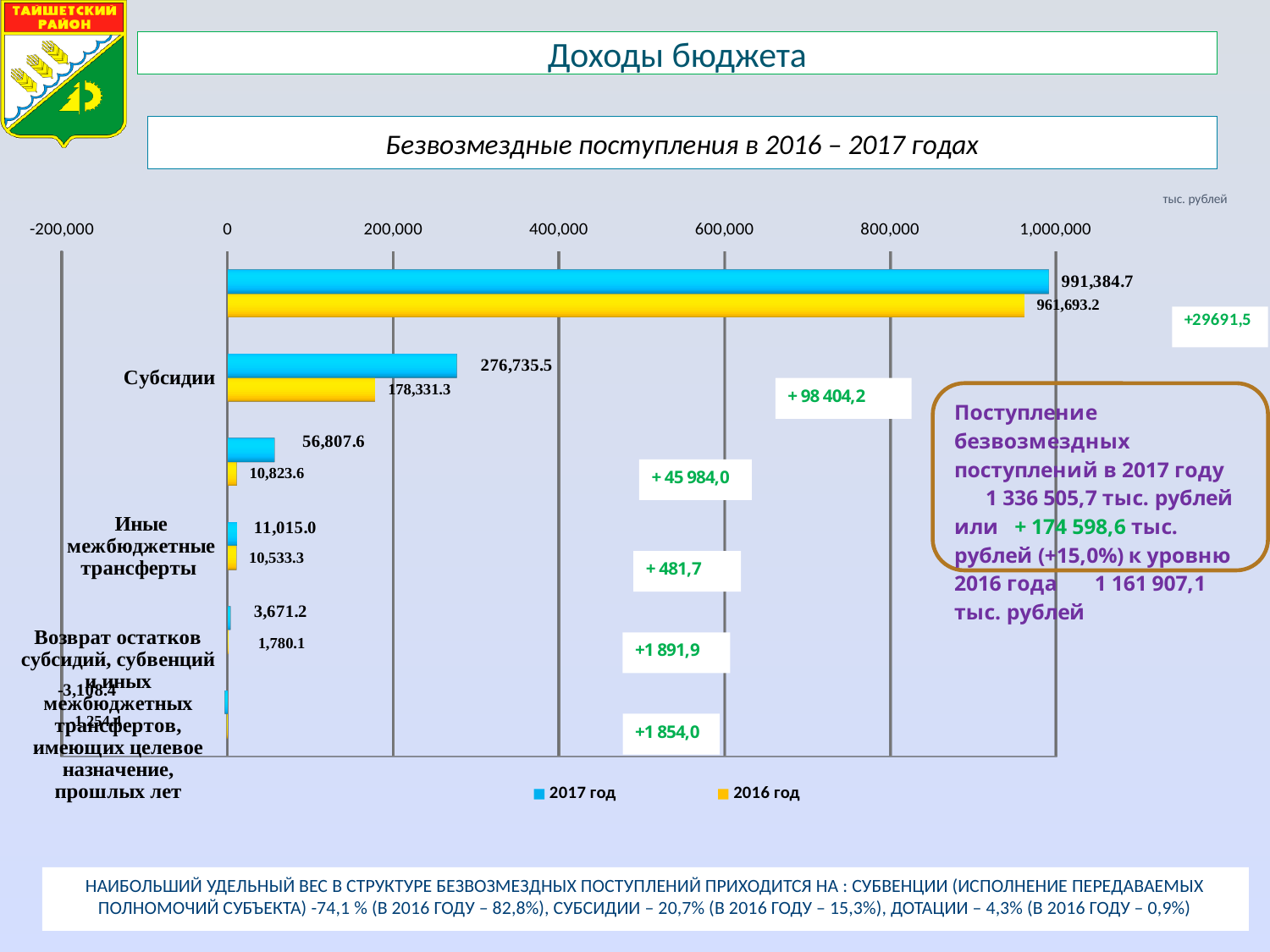
What is the 2017 год value for Субсидии? 276,735.5 What are the two series named in the chart legend? 2017 год and 2016 год Is the 2017 год value for Субсидии greater or less than 200,000? greater What unit is indicated in the top right corner of the chart? тыс. рублей What is the 2017 год value for Иные межбюджетные трансферты? 11,015.0 For Субсидии, which is larger: the 2017 год value or the 2016 год value? 2017 год What is the largest 2017 год value shown in the chart? 991,384.7 What is the 2016 год value for Иные межбюджетные трансферты? 10,533.3 How many series does the chart legend list? 2 What is the difference between the 2017 год and 2016 год values for Субсидии? 98,404.2 What type of chart is shown on the slide? bar chart What is the 2016 год value for Субсидии? 178,331.3